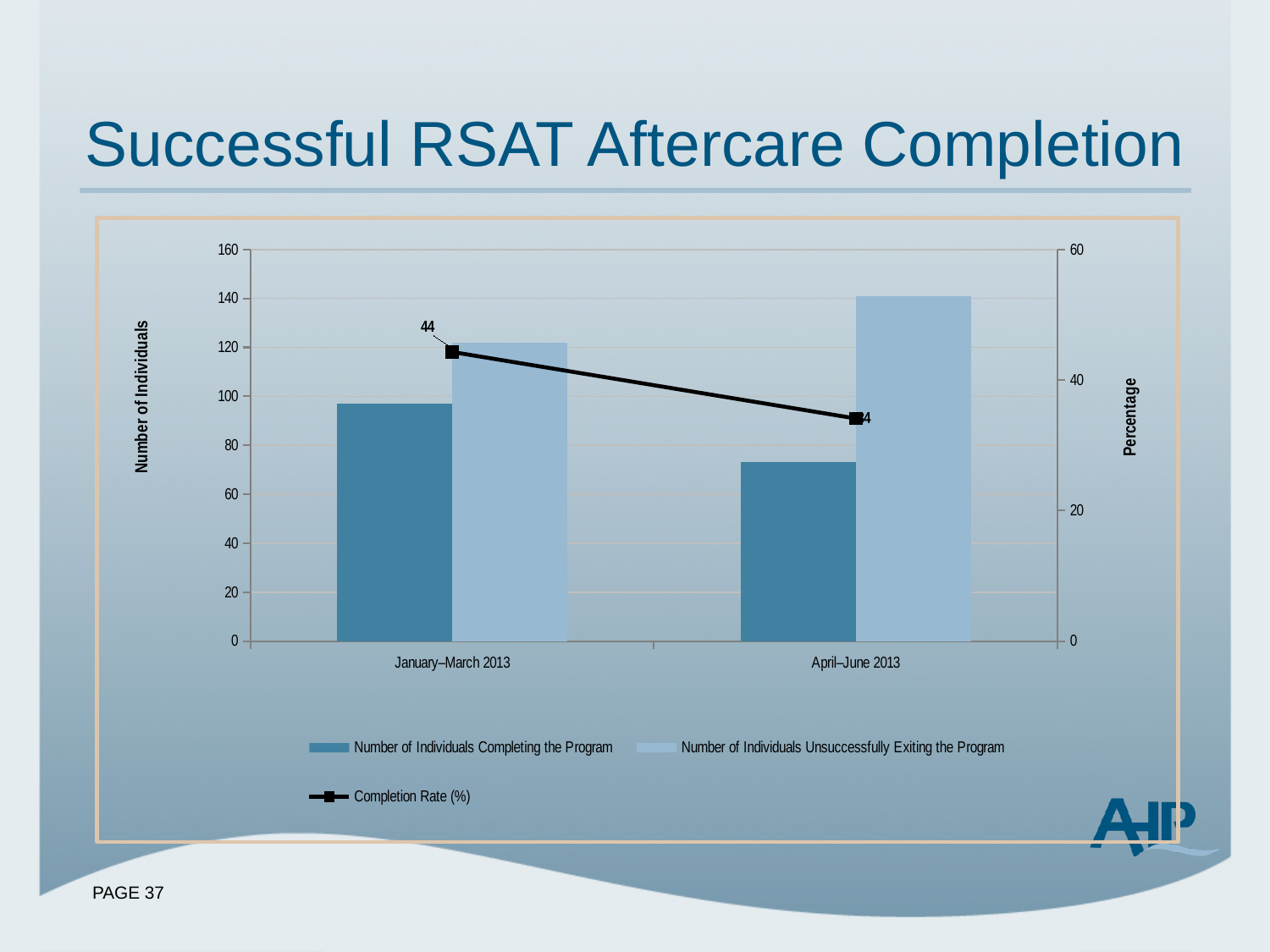
What kind of chart is this? Combined bar and line chart What is the label of the right-hand vertical axis? Percentage How many categories are shown on the x axis? 2 Does the Completion Rate (%) rise or fall from January–March 2013 to April–June 2013? Fall Is the Number of Individuals Unsuccessfully Exiting the Program for April–June 2013 greater or less than 120? greater Which period has the higher Number of Individuals Unsuccessfully Exiting the Program, January–March 2013 or April–June 2013? April–June 2013 Which period has the lower Number of Individuals Completing the Program? April–June 2013 What is the Completion Rate (%) for January–March 2013? 44 How many series does the legend list? 3 What is the title of the chart? Successful RSAT Aftercare Completion Is the Number of Individuals Completing the Program for January–March 2013 greater or less than 80? greater Is the Number of Individuals Completing the Program for April–June 2013 greater or less than 80? less